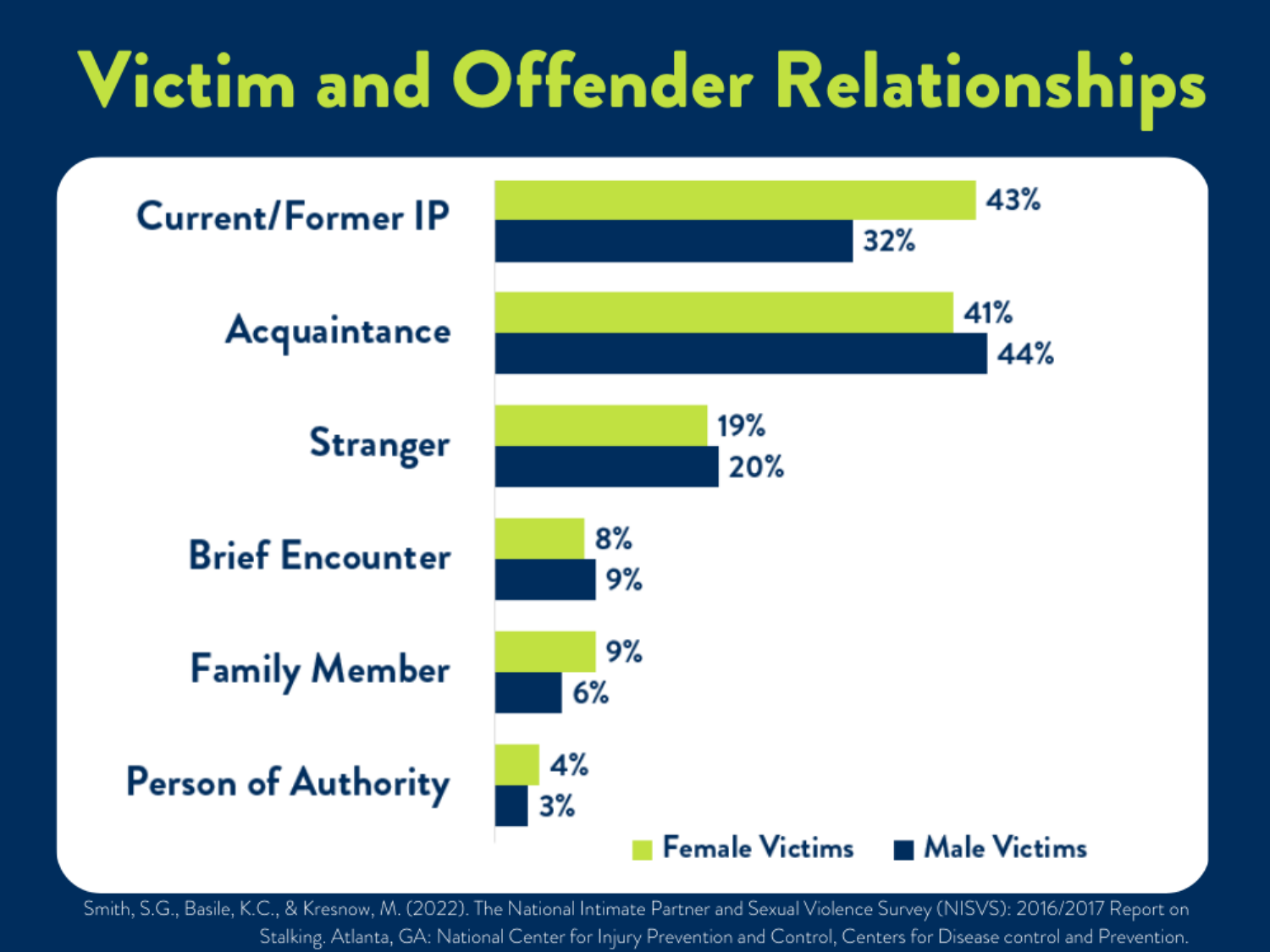
Which is larger for the Stranger category, the Female Victims value or the Male Victims value? Male Victims Which category has the highest value for Female Victims? Current/Former IP What is the value for Female Victims in the Current/Former IP category? 43% What kind of chart is shown on the slide? Bar chart How many relationship categories are shown on the chart? 6 Which category has the lowest value for Male Victims? Person of Authority What is the difference between the Female Victims and Male Victims values for Current/Former IP? 11% What is the title of the slide? Victim and Offender Relationships What is the value for Male Victims in the Family Member category? 6% How many series does the legend list? 2 What is the value for Male Victims in the Acquaintance category? 44% Which colour represents Female Victims in the chart? Green